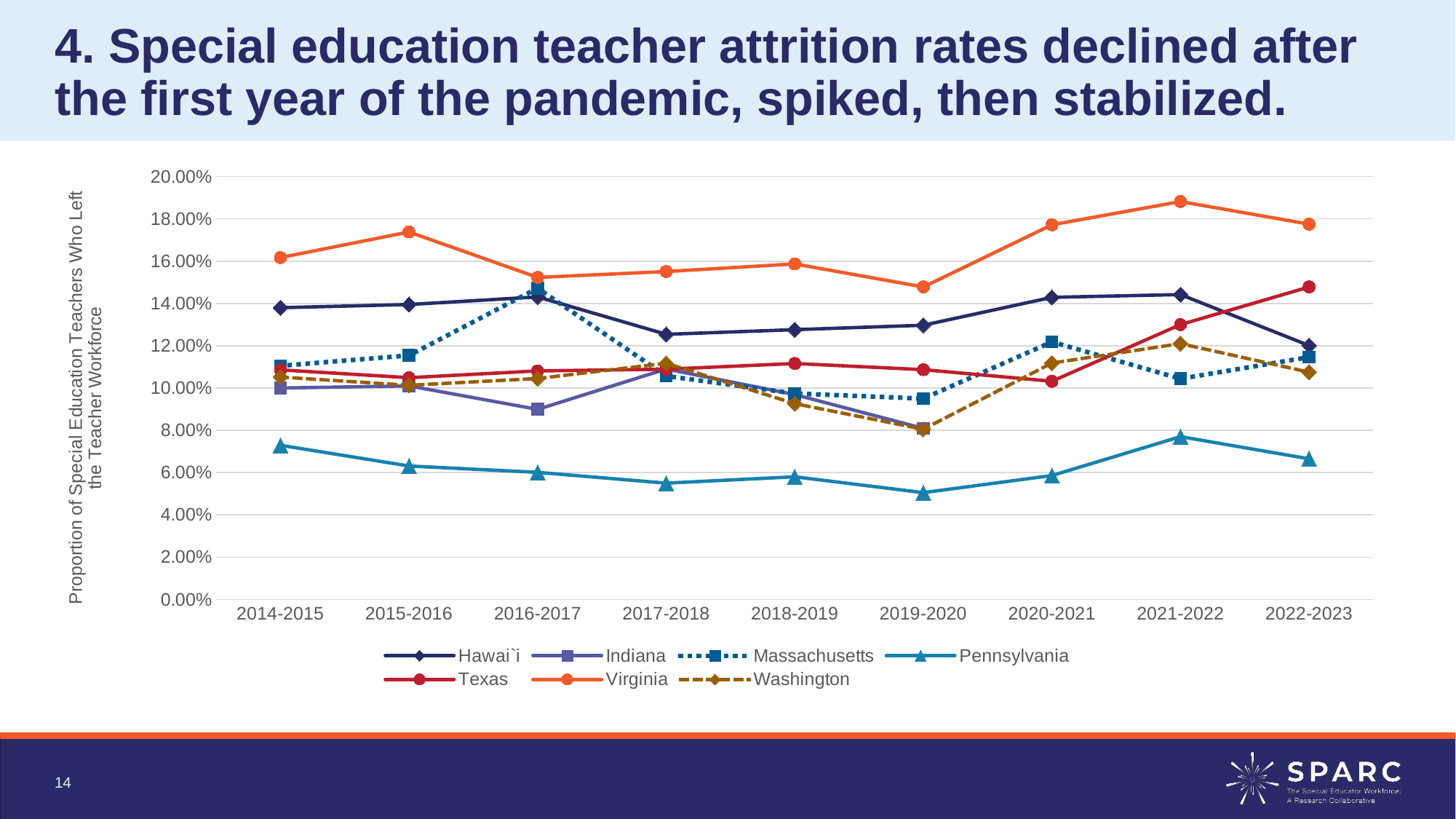
Is the value for Hawai`i in 2014-2015 greater or less than 12.00%? greater Is the value for Virginia in 2021-2022 greater or less than 18.00%? greater Does the Virginia line rise or fall from 2019-2020 to 2021-2022? rise What is the title of the y axis? Proportion of Special Education Teachers Who Left the Teacher Workforce How many series does the legend list? 7 How many school years are shown along the x axis? 9 Which state has the lowest attrition rate in 2014-2015? Pennsylvania What kind of chart is shown on the slide? line chart Which state has the highest attrition rate in 2022-2023? Virginia In 2022-2023, which is larger: the value for Texas or the value for Hawai`i? Texas In which school year does Virginia reach its highest value? 2021-2022 Is the value for Pennsylvania in 2019-2020 greater or less than 6.00%? less